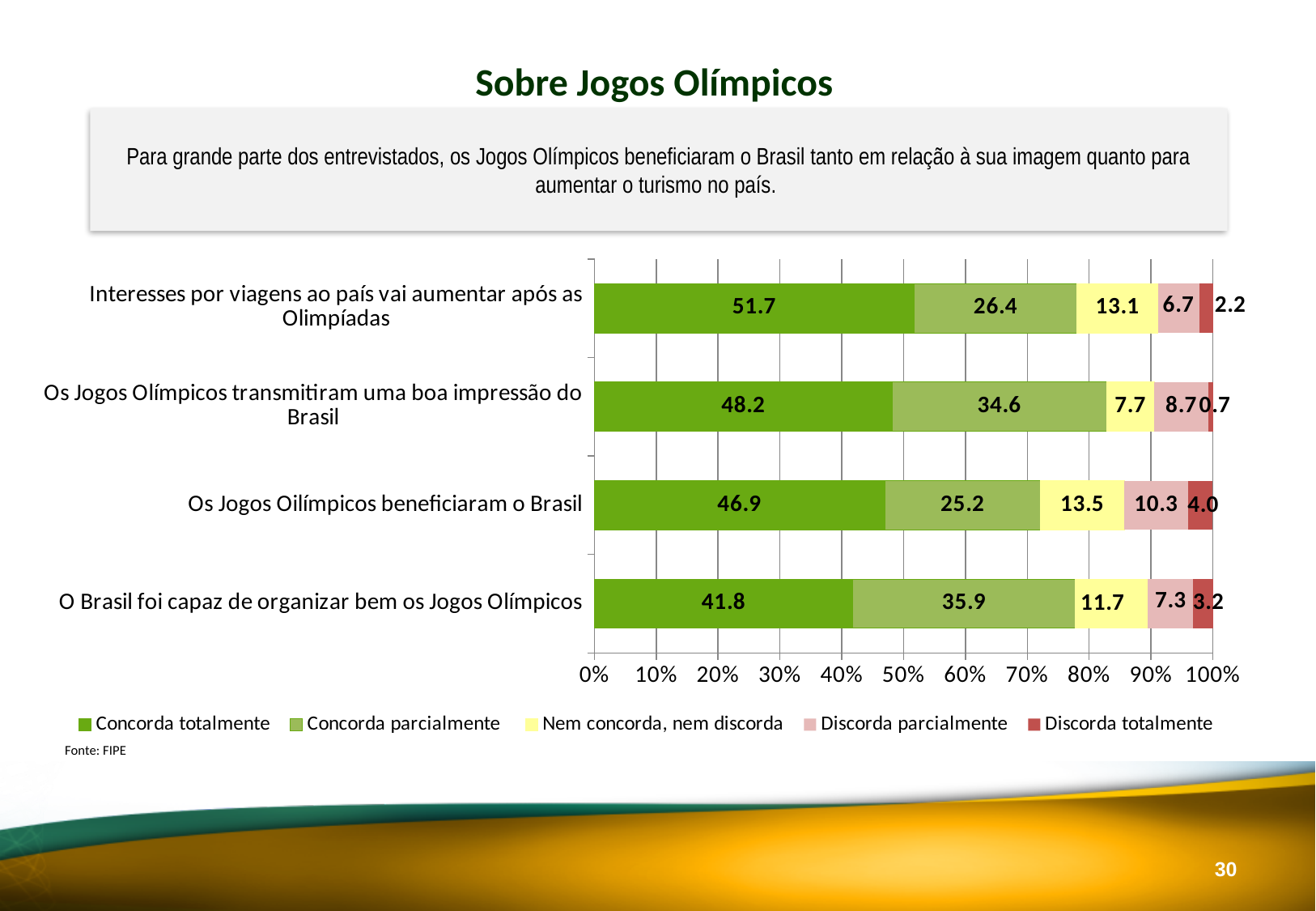
What is the value of "Concorda parcialmente" for "O Brasil foi capaz de organizar bem os Jogos Olímpicos"? 35.9 Which statement has the highest "Concorda totalmente" value? Interesses por viagens ao país vai aumentar após as Olimpíadas What is the value of "Discorda parcialmente" for "Os Jogos Oilímpicos beneficiaram o Brasil"? 10.3 What is the title of the slide? Sobre Jogos Olímpicos How many statements (categories) are shown in the chart? 4 How many series does the legend list? 5 What is the difference between the "Concorda totalmente" values for "Interesses por viagens ao país vai aumentar após as Olimpíadas" and "O Brasil foi capaz de organizar bem os Jogos Olímpicos"? 9.9 Which statement has the lowest "Concorda totalmente" value? O Brasil foi capaz de organizar bem os Jogos Olímpicos Which has a larger "Discorda totalmente" value: "Os Jogos Oilímpicos beneficiaram o Brasil" or "O Brasil foi capaz de organizar bem os Jogos Olímpicos"? Os Jogos Oilímpicos beneficiaram o Brasil What is the value of "Concorda totalmente" for "Interesses por viagens ao país vai aumentar após as Olimpíadas"? 51.7 Which statement has the highest "Discorda totalmente" value? Os Jogos Oilímpicos beneficiaram o Brasil What kind of chart is shown on the slide? Stacked bar chart